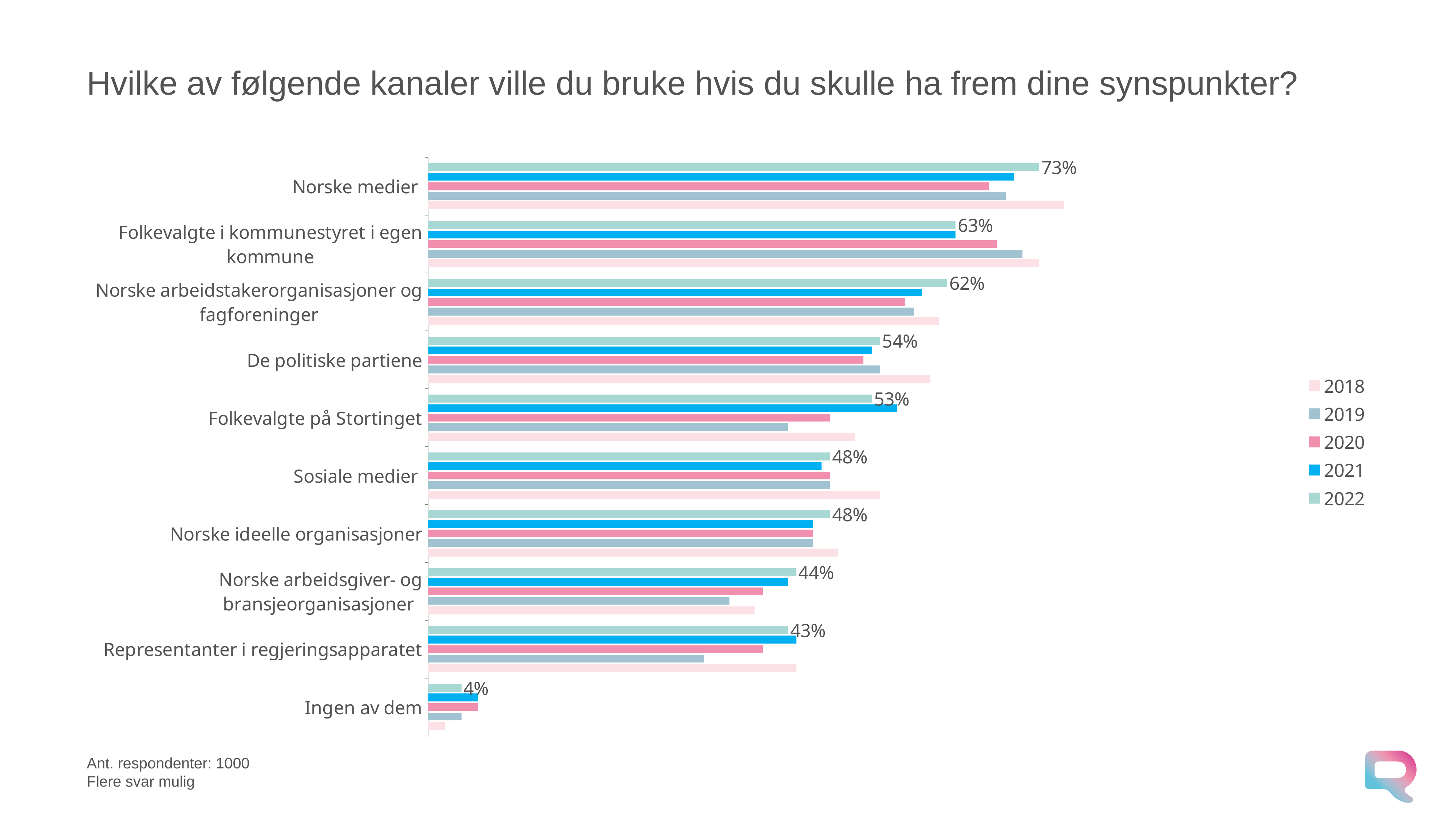
Which category has the lowest 2022 value? Ingen av dem What is the 2022 value for Folkevalgte i kommunestyret i egen kommune? 63% Which years are listed in the legend? 2018, 2019, 2020, 2021, 2022 What is the 2022 value for Norske arbeidsgiver- og bransjeorganisasjoner? 44% How many categories are shown on the chart? 10 What kind of chart is shown on the slide? Bar chart How many series does the legend list? 5 What is the 2022 value for Ingen av dem? 4% What is the 2022 value for Norske medier? 73% What is the difference between the 2022 values for Norske medier and Ingen av dem? 69 percentage points Which category has the highest 2022 value? Norske medier For Folkevalgte på Stortinget, which is larger: the 2021 bar or the 2019 bar? 2021